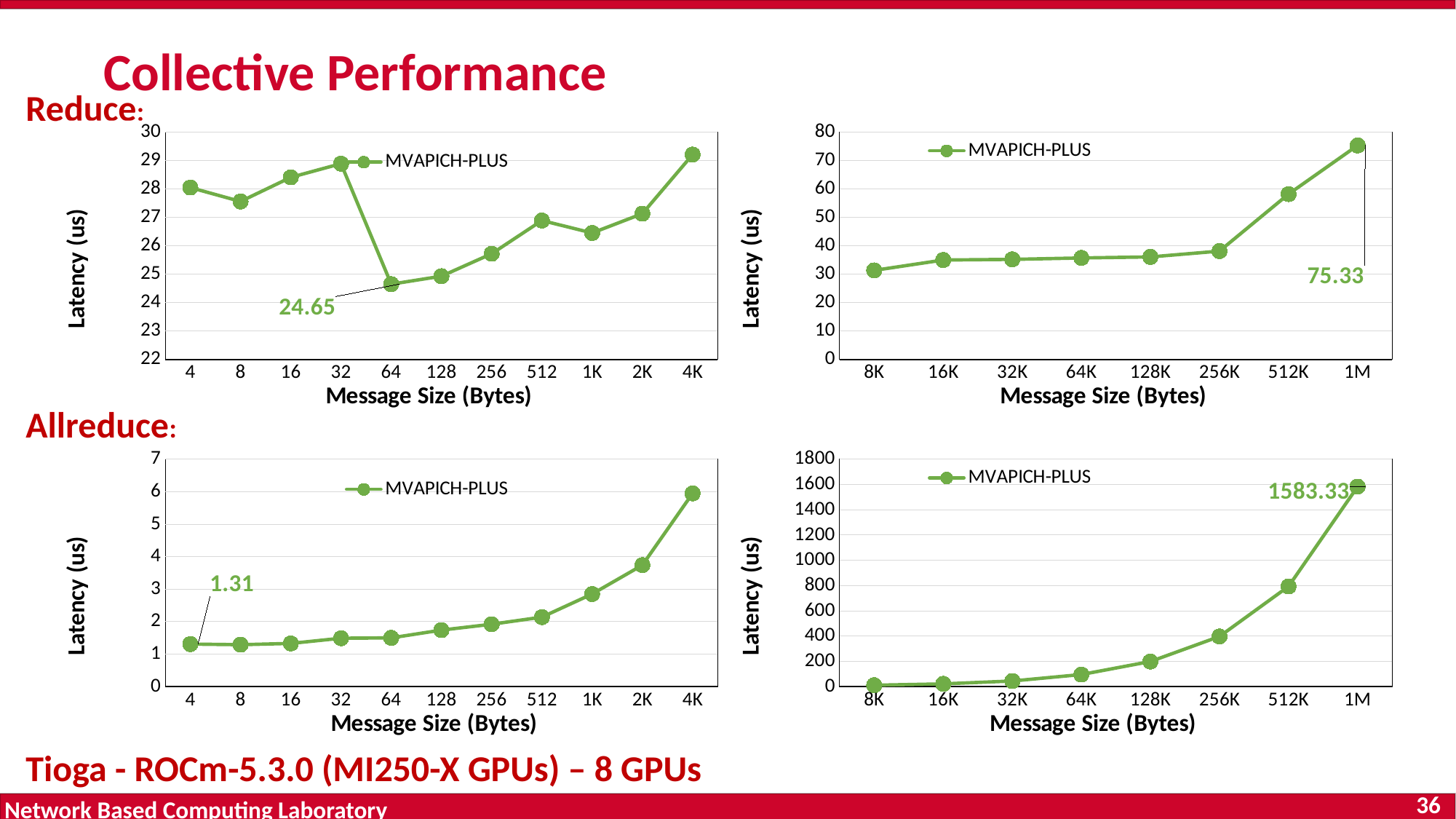
What type of chart is the bottom-left Allreduce chart? Line chart In the top-right Reduce chart (message sizes 8K to 1M), what is the latency labeled at message size 1M? 75.33 How many message sizes are plotted on the x axis of the top-right Reduce chart? 8 In the bottom-left Allreduce chart (message sizes 4 to 4K), what is the latency labeled at message size 4? 1.31 In the top-right Reduce chart, which message size has the highest latency? 1M In the bottom-right Allreduce chart, is the latency at message size 512K greater or less than 600? greater What series name does the legend show in the bottom-right Allreduce chart? MVAPICH-PLUS In the bottom-right Allreduce chart (message sizes 8K to 1M), what is the latency labeled at message size 1M? 1583.33 In the top-left Reduce chart (message sizes 4 to 4K), what is the latency labeled at message size 64? 24.65 In the top-left Reduce chart, which message size has the lowest latency? 64 In the bottom-left Allreduce chart, which has the higher latency: message size 2K or message size 4K? 4K